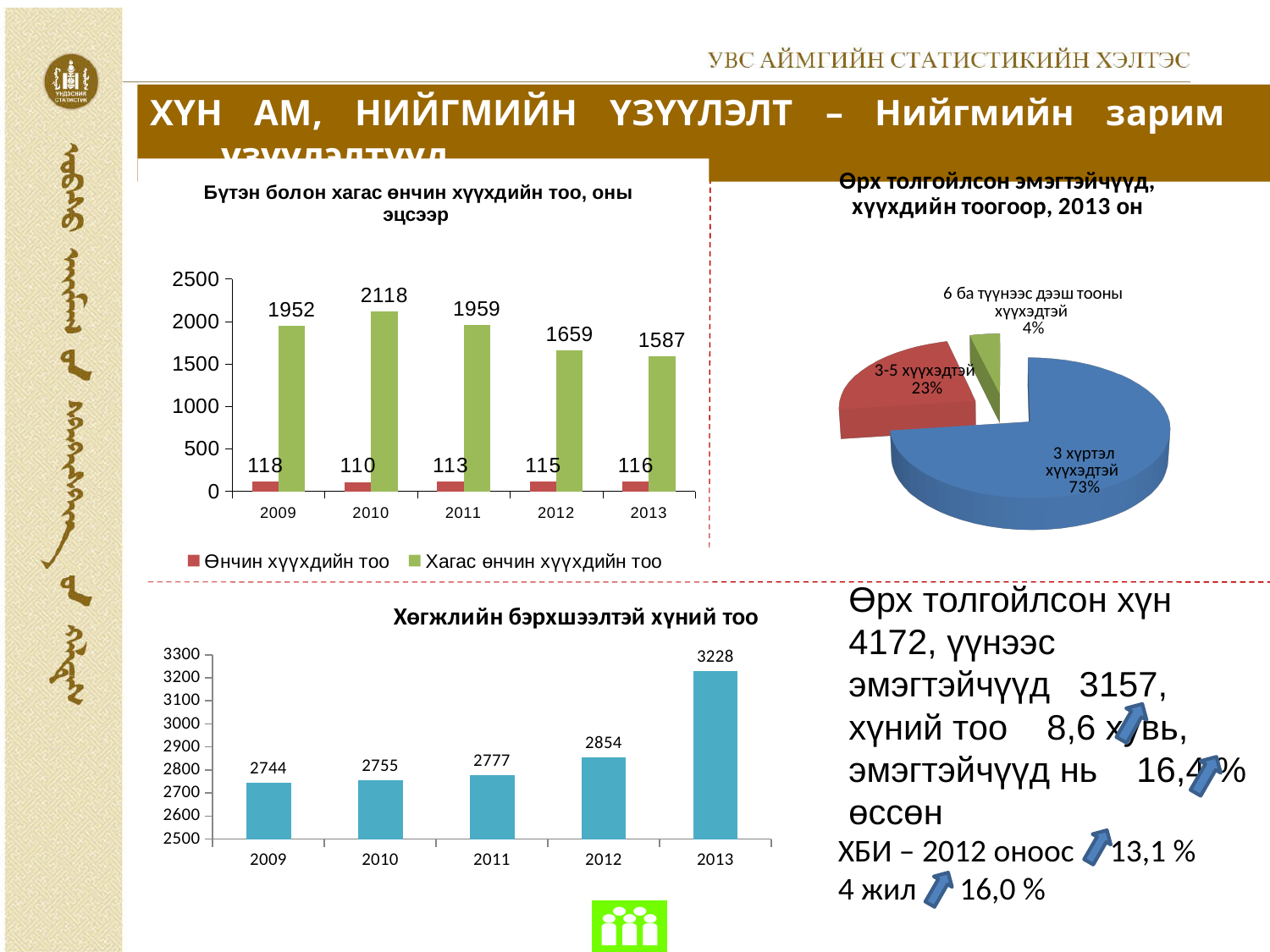
In the chart 'Бүтэн болон хагас өнчин хүүхдийн тоо, оны эцсээр', what is the value of 'Өнчин хүүхдийн тоо' for 2013? 116 How many series does the legend of the chart 'Бүтэн болон хагас өнчин хүүхдийн тоо, оны эцсээр' list? 2 In the pie chart 'Өрх толгойлсон эмэгтэйчүүд, хүүхдийн тоогоор, 2013 он', what share does '3-5 хүүхэдтэй' have? 23% In the chart 'Хөгжлийн бэрхшээлтэй хүний тоо', what is the value for 2012? 2854 In the chart 'Бүтэн болон хагас өнчин хүүхдийн тоо, оны эцсээр', which year has the lowest value for 'Өнчин хүүхдийн тоо'? 2010 In the chart 'Бүтэн болон хагас өнчин хүүхдийн тоо, оны эцсээр', which year has the highest value for 'Хагас өнчин хүүхдийн тоо'? 2010 In the chart 'Бүтэн болон хагас өнчин хүүхдийн тоо, оны эцсээр', what is the difference between the 'Хагас өнчин хүүхдийн тоо' values for 2012 and 2013? 72 In the pie chart 'Өрх толгойлсон эмэгтэйчүүд, хүүхдийн тоогоор, 2013 он', which slice is the largest? 3 хүртэл хүүхэдтэй What kind of chart is 'Өрх толгойлсон эмэгтэйчүүд, хүүхдийн тоогоор, 2013 он'? pie chart In the chart 'Бүтэн болон хагас өнчин хүүхдийн тоо, оны эцсээр', what is the value of 'Хагас өнчин хүүхдийн тоо' for 2010? 2118 In the chart 'Хөгжлийн бэрхшээлтэй хүний тоо', do the values rise or fall from 2009 to 2013? rise In the chart 'Хөгжлийн бэрхшээлтэй хүний тоо', what is the difference between the values for 2013 and 2009? 484